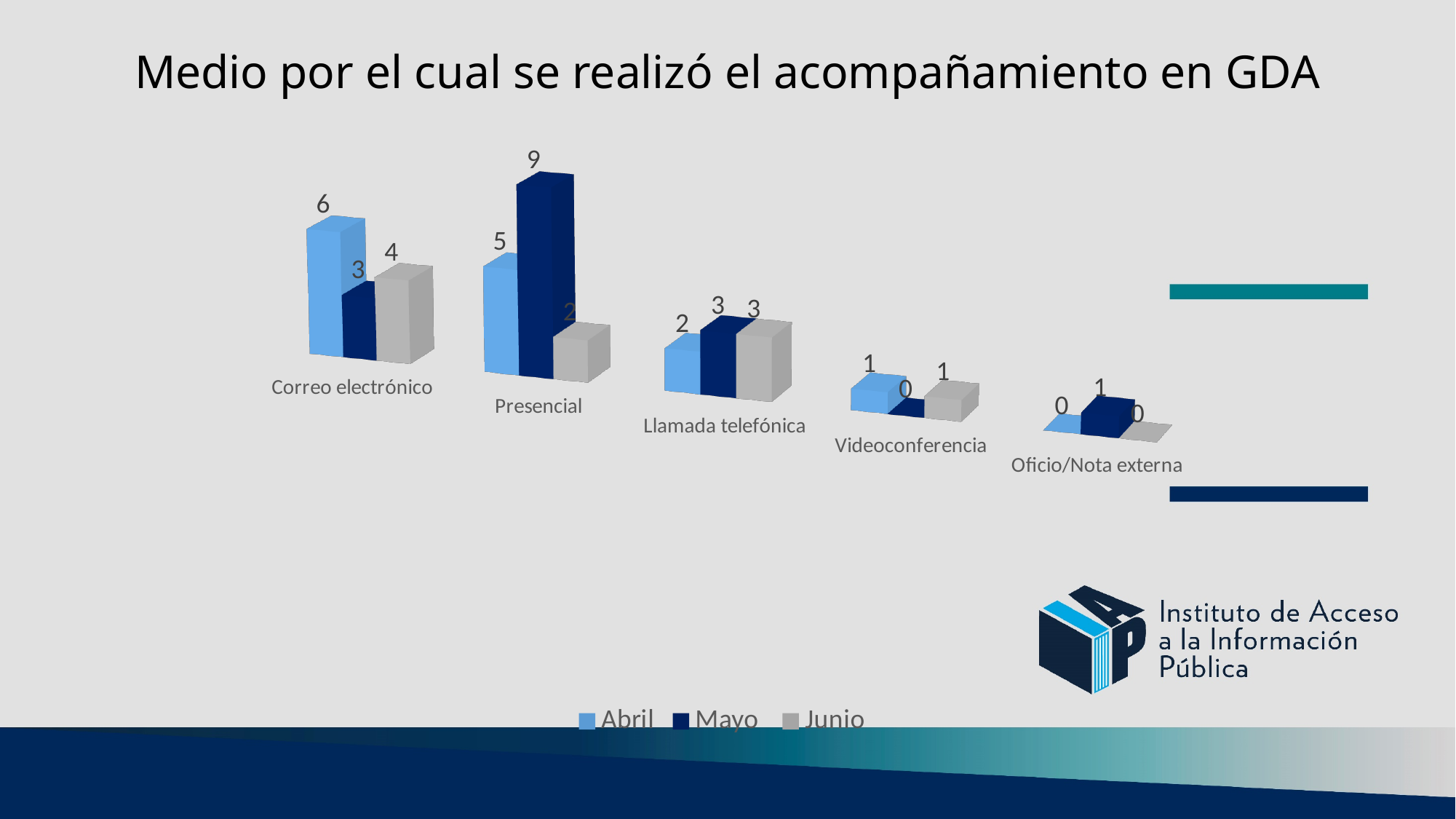
What is the value for Junio in the Llamada telefónica category? 3 Which category has the lowest value for the Abril series? Oficio/Nota externa What is the value for Mayo in the Presencial category? 9 How many series does the legend list? 3 How many categories are shown on the x axis? 5 Which is larger for Correo electrónico: the Abril value or the Junio value? Abril What is the difference between the Mayo and Junio values for Presencial? 7 What kind of chart is shown on the slide? Bar chart What is the value for Mayo in the Videoconferencia category? 0 What is the title of the chart? Medio por el cual se realizó el acompañamiento en GDA Which category has the highest value for the Mayo series? Presencial What is the value for Abril in the Correo electrónico category? 6